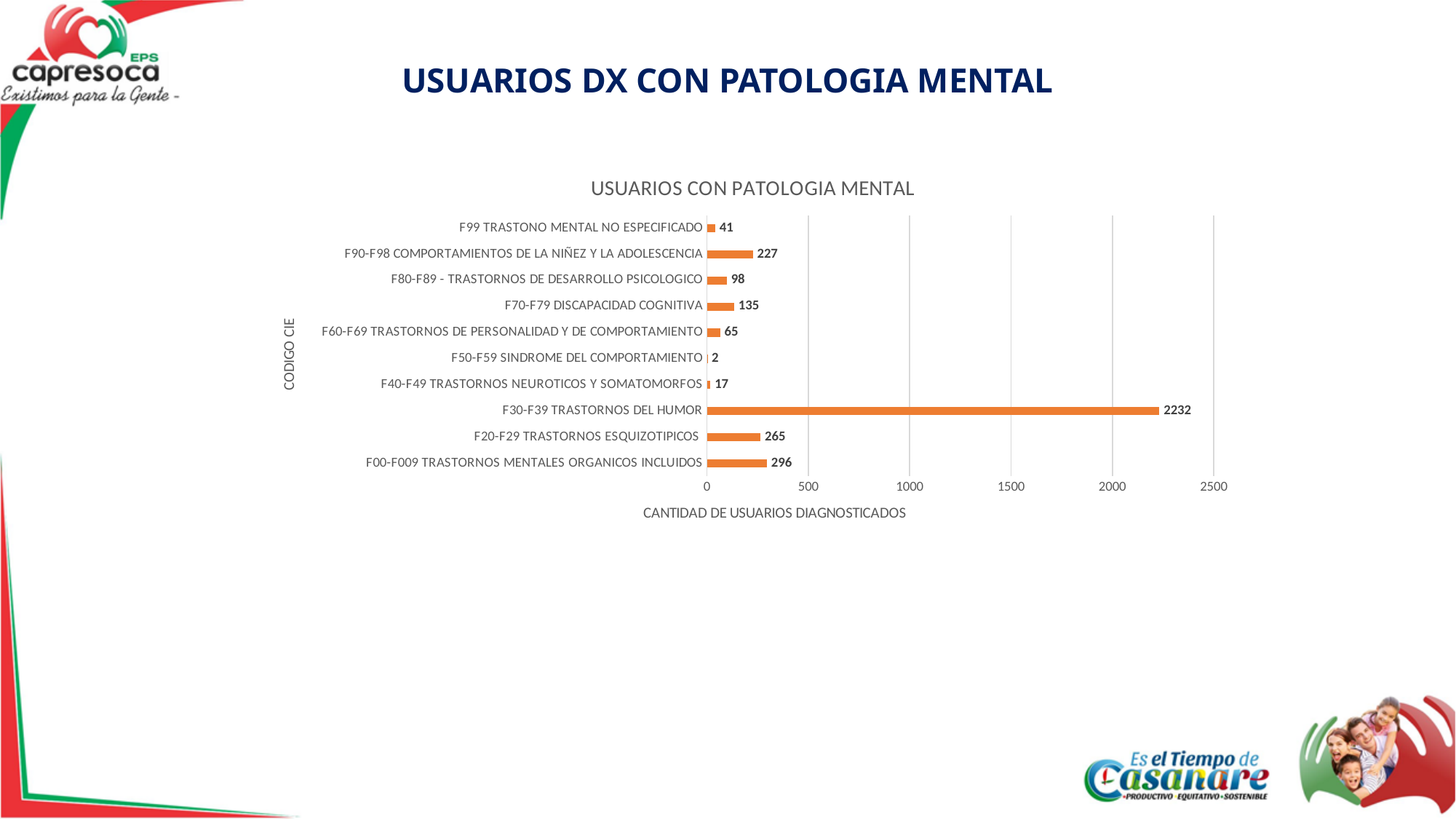
What kind of chart is shown on the slide? bar chart What is the label of the horizontal axis? CANTIDAD DE USUARIOS DIAGNOSTICADOS What is the title of the chart? USUARIOS CON PATOLOGIA MENTAL Which is larger, the value for F80-F89 - TRASTORNOS DE DESARROLLO PSICOLOGICO or the value for F60-F69 TRASTORNOS DE PERSONALIDAD Y DE COMPORTAMIENTO? F80-F89 - TRASTORNOS DE DESARROLLO PSICOLOGICO What is the difference between the values for F00-F009 TRASTORNOS MENTALES ORGANICOS INCLUIDOS and F20-F29 TRASTORNOS ESQUIZOTIPICOS? 31 What is the value for F90-F98 COMPORTAMIENTOS DE LA NIÑEZ Y LA ADOLESCENCIA? 227 Which category has the lowest value? F50-F59 SINDROME DEL COMPORTAMIENTO What is the value for F30-F39 TRASTORNOS DEL HUMOR? 2232 Which category has the highest value? F30-F39 TRASTORNOS DEL HUMOR How many categories are shown in the chart? 10 What is the value for F70-F79 DISCAPACIDAD COGNITIVA? 135 Is the value for F30-F39 TRASTORNOS DEL HUMOR greater or less than 2000? greater